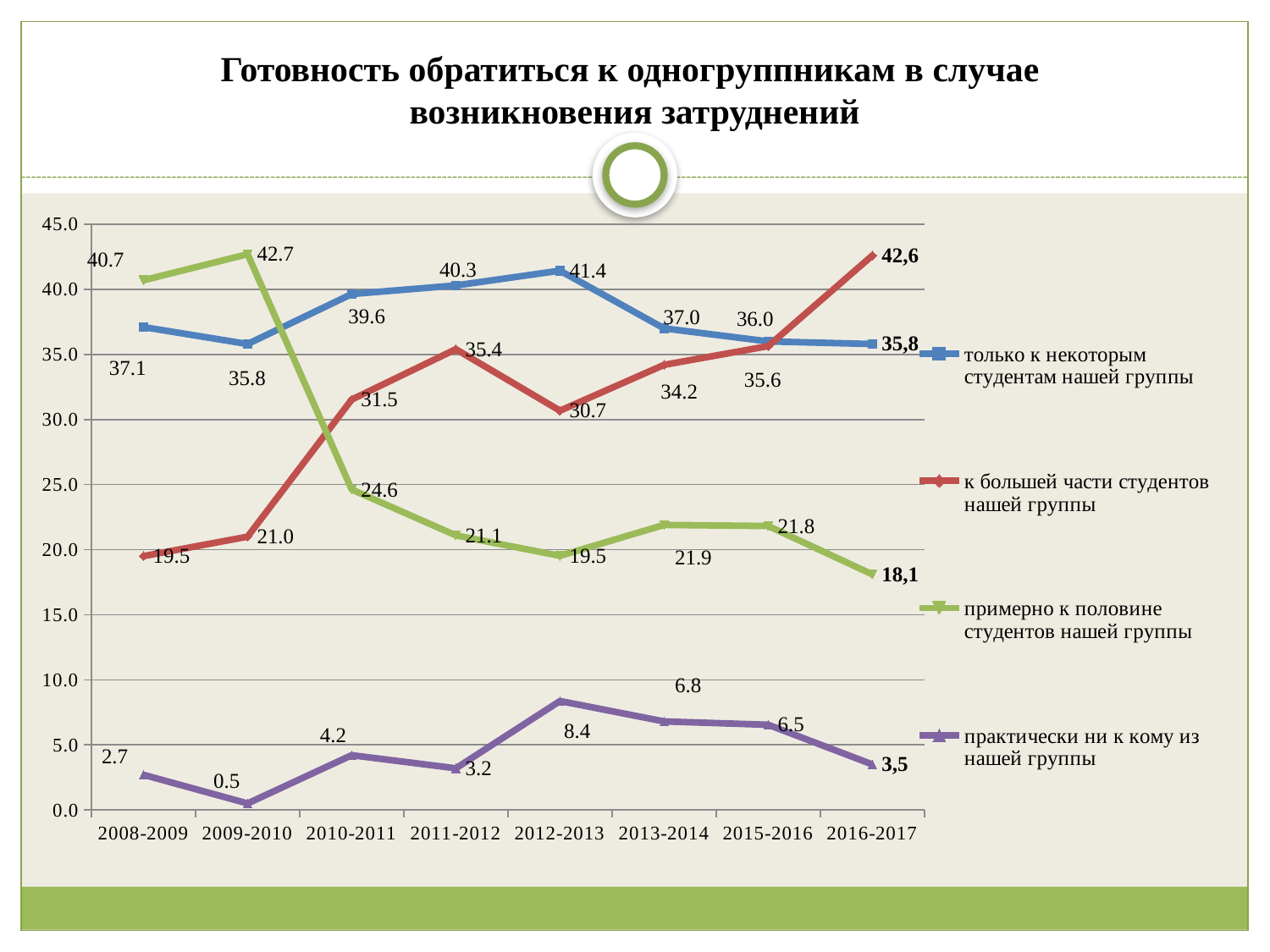
Does the value for 'примерно к половине студентов нашей группы' rise or fall from 2009-2010 to 2012-2013? fall What is the value for 'только к некоторым студентам нашей группы' in 2012-2013? 41.4 What kind of chart is shown on the slide? line chart What is the difference between the 2012-2013 and 2013-2014 values for 'только к некоторым студентам нашей группы'? 4.4 What is the value for 'к большей части студентов нашей группы' in 2016-2017? 42,6 What is the value for 'практически ни к кому из нашей группы' in 2009-2010? 0.5 What is the title of the chart? Готовность обратиться к одногруппникам в случае возникновения затруднений In 2010-2011, which series has the larger value: 'только к некоторым студентам нашей группы' or 'примерно к половине студентов нашей группы'? только к некоторым студентам нашей группы How many academic-year categories are shown on the x axis? 8 In which year is the value for 'практически ни к кому из нашей группы' lowest? 2009-2010 How many series does the legend list? 4 In which year is the value for 'примерно к половине студентов нашей группы' highest? 2009-2010